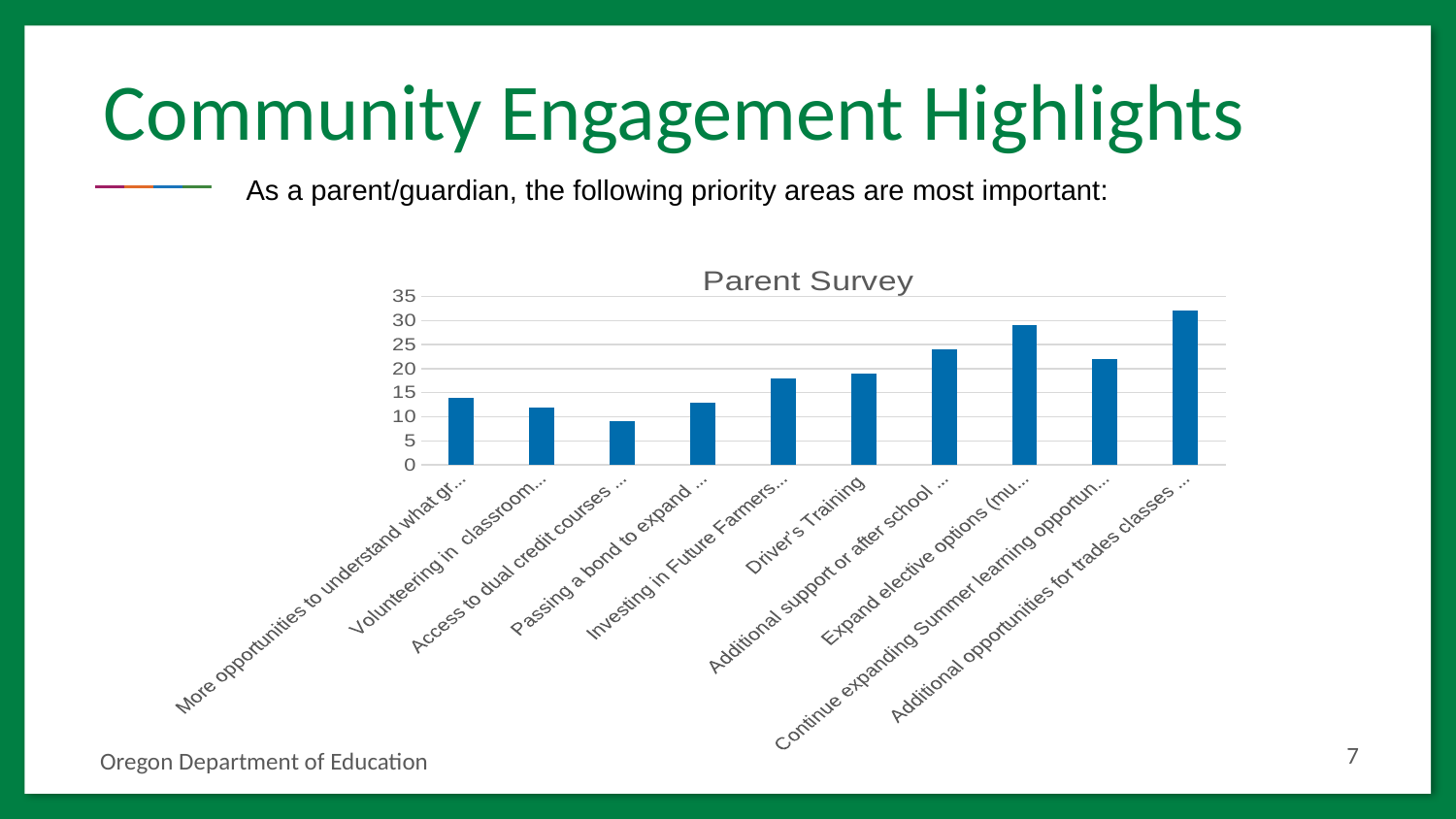
What is the title of the chart? Parent Survey What is the highest value shown on the vertical axis of the chart? 35 Which is larger, the value for Driver's Training or the value for Additional support or after school? Additional support or after school Which is larger, the value for Expand elective options or the value for Continue expanding Summer learning opportunities? Expand elective options Is the value for Driver's Training greater or less than 15? greater How many categories (bars) does the chart show? 10 Which category has the lowest value in the chart? Access to dual credit courses What kind of chart is shown on the slide? bar chart Is the value for Expand elective options greater or less than 25? greater Which category has the highest value in the chart? Additional opportunities for trades classes Is the value for Additional opportunities for trades classes greater or less than 30? greater